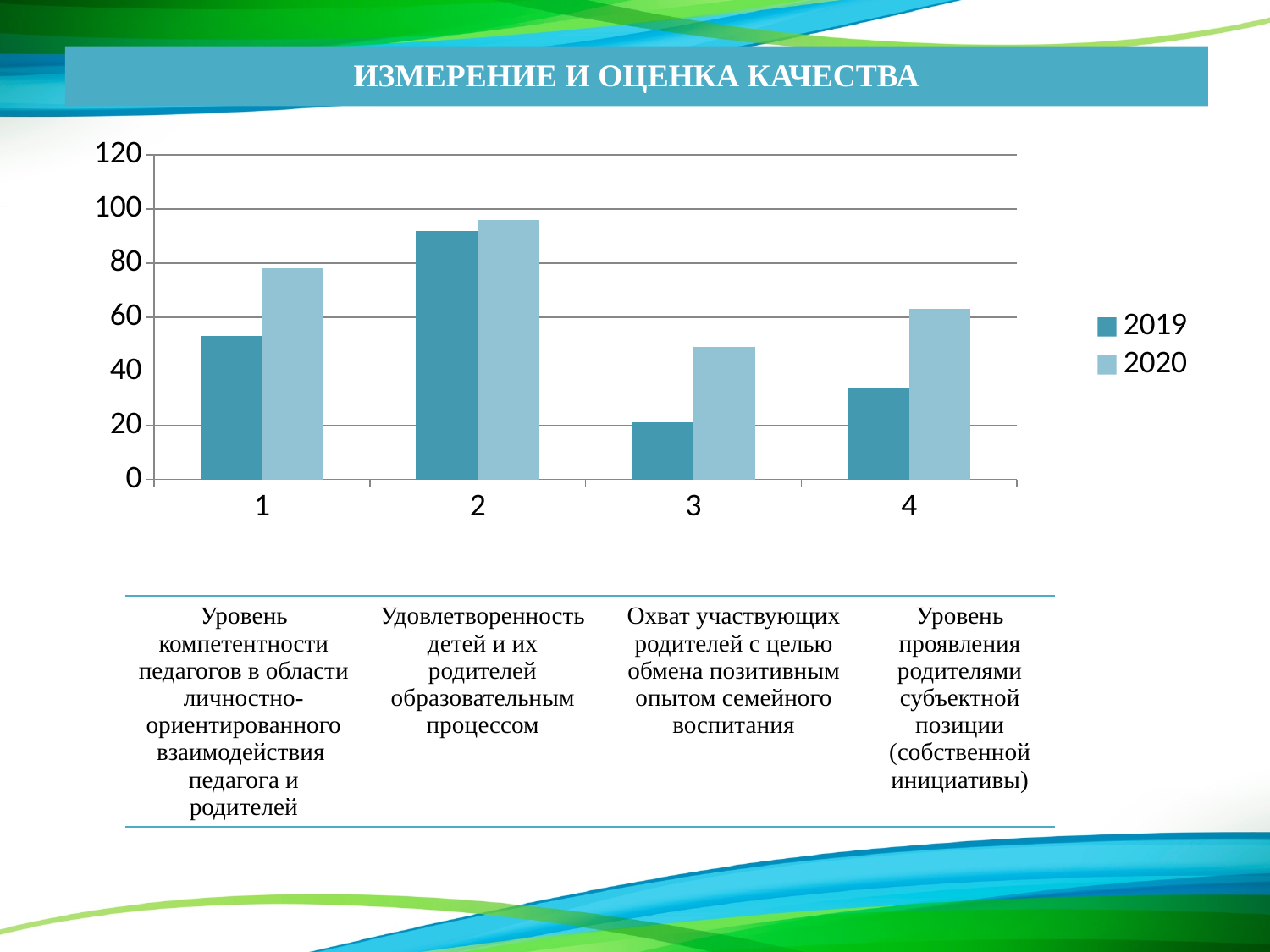
How many categories are shown on the x axis? 4 What is the title of the slide above the chart? ИЗМЕРЕНИЕ И ОЦЕНКА КАЧЕСТВА Which category has the lowest value for the 2020 series? 3 Is the 2019 value for category 3 greater or less than 40? less Is the 2020 value for category 2 greater or less than 80? greater Which category has the lowest value for the 2019 series? 3 For category 1, which series has the larger value, 2019 or 2020? 2020 Which category has the highest value for the 2019 series? 2 Is the 2019 value for category 4 greater or less than 40? less How many series does the legend list? 2 What kind of chart is shown on the slide? bar chart Which category has the highest value for the 2020 series? 2